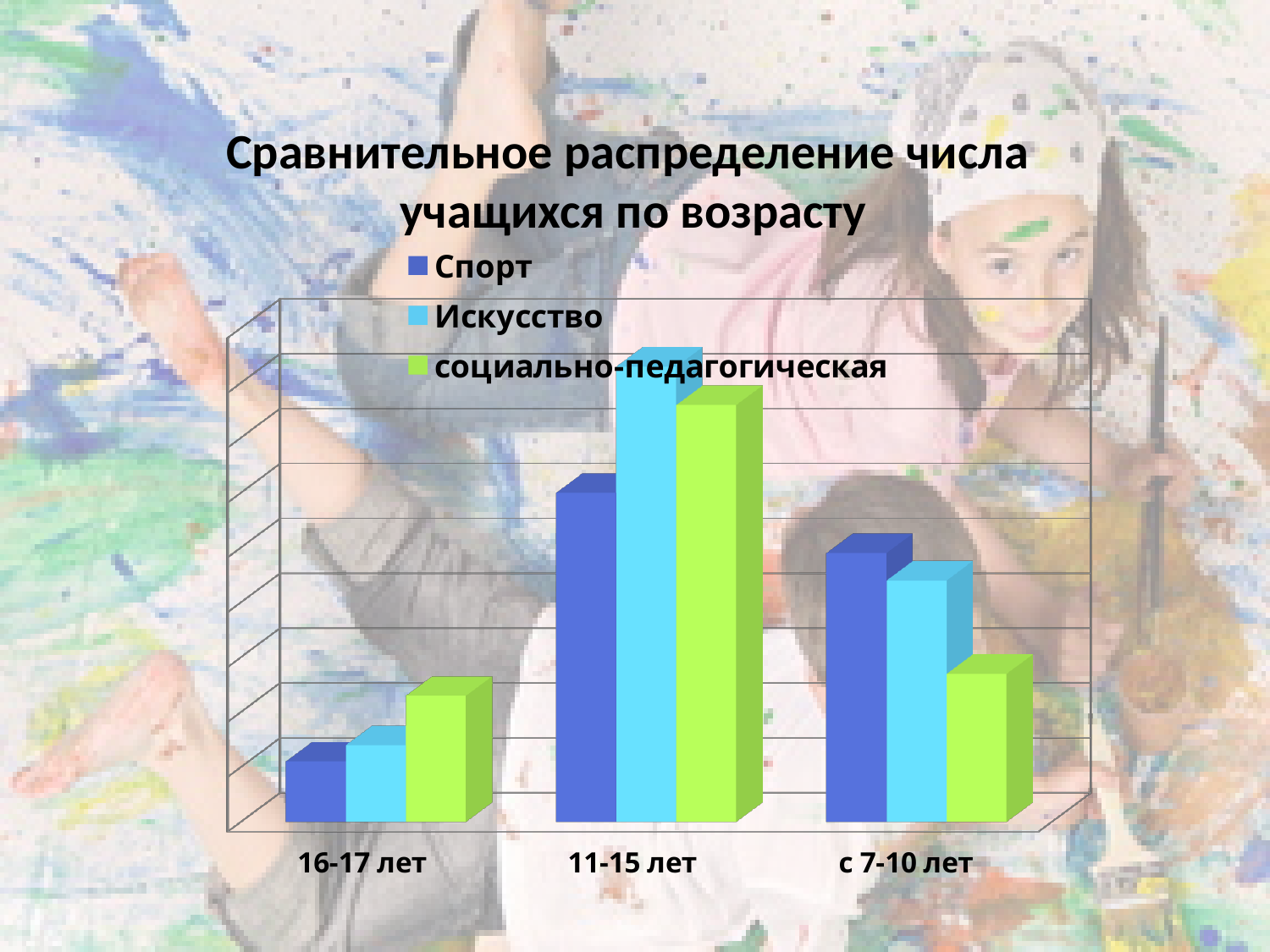
For the социально-педагогическая series, which age category has the lowest bar? 16-17 лет What is the title of the chart? Сравнительное распределение числа учащихся по возрасту Within the 11-15 лет category, which series has the highest bar? Искусство For the Спорт series, which age category has the highest bar? 11-15 лет Which series is shown in green in the chart? социально-педагогическая How many age categories are shown on the x axis of the chart? 3 Is the Спорт bar larger for с 7-10 лет or for 16-17 лет? с 7-10 лет How many series does the chart's legend list? 3 What kind of chart is shown on the slide? bar chart Within the 16-17 лет category, which series has the highest bar? социально-педагогическая For the Искусство series, which age category has the lowest bar? 16-17 лет Within the с 7-10 лет category, which series has the lowest bar? социально-педагогическая